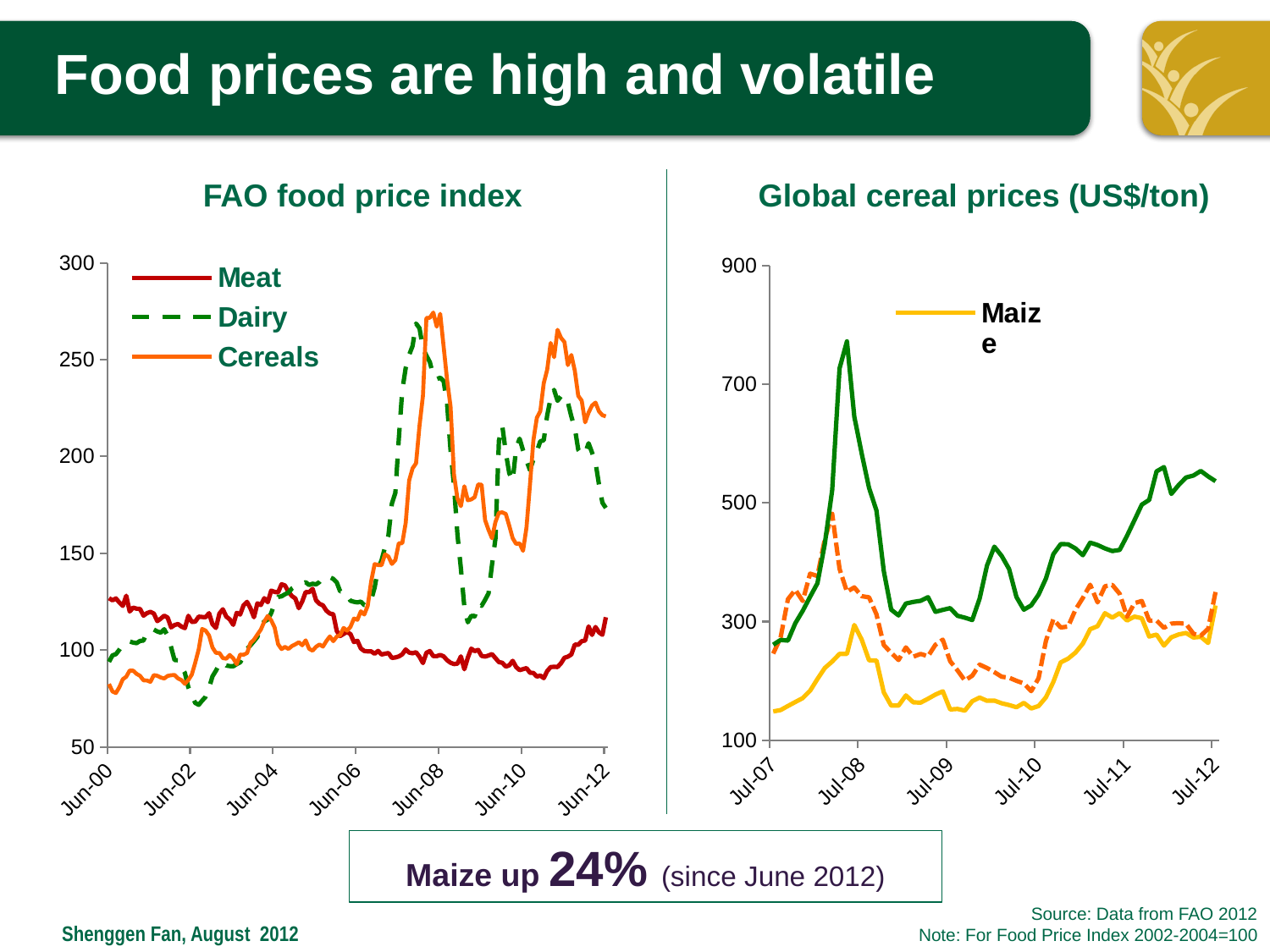
What kind of chart is the 'FAO food price index' chart? line chart In the 'FAO food price index' chart, is the value for Cereals at Jun-12 greater or less than 200? greater How many series does the legend of the 'Global cereal prices (US$/ton)' chart list? 1 In the 'FAO food price index' chart, is the peak value of Cereals greater or less than 250? greater In the 'FAO food price index' chart, does the Cereals series rise or fall between Jun-06 and Jun-08? rise How many series does the legend of the 'FAO food price index' chart list? 3 In the 'FAO food price index' chart, is the value for Meat at Jun-12 greater or less than 150? less In the 'Global cereal prices (US$/ton)' chart, does the Maize series rise or fall between Jul-10 and Jul-11? rise Which series are listed in the legend of the 'FAO food price index' chart? Meat, Dairy, Cereals In the 'FAO food price index' chart, does the Meat series rise or fall between Jun-04 and Jun-10? fall In the 'FAO food price index' chart, which is larger at Jun-12, Cereals or Meat? Cereals